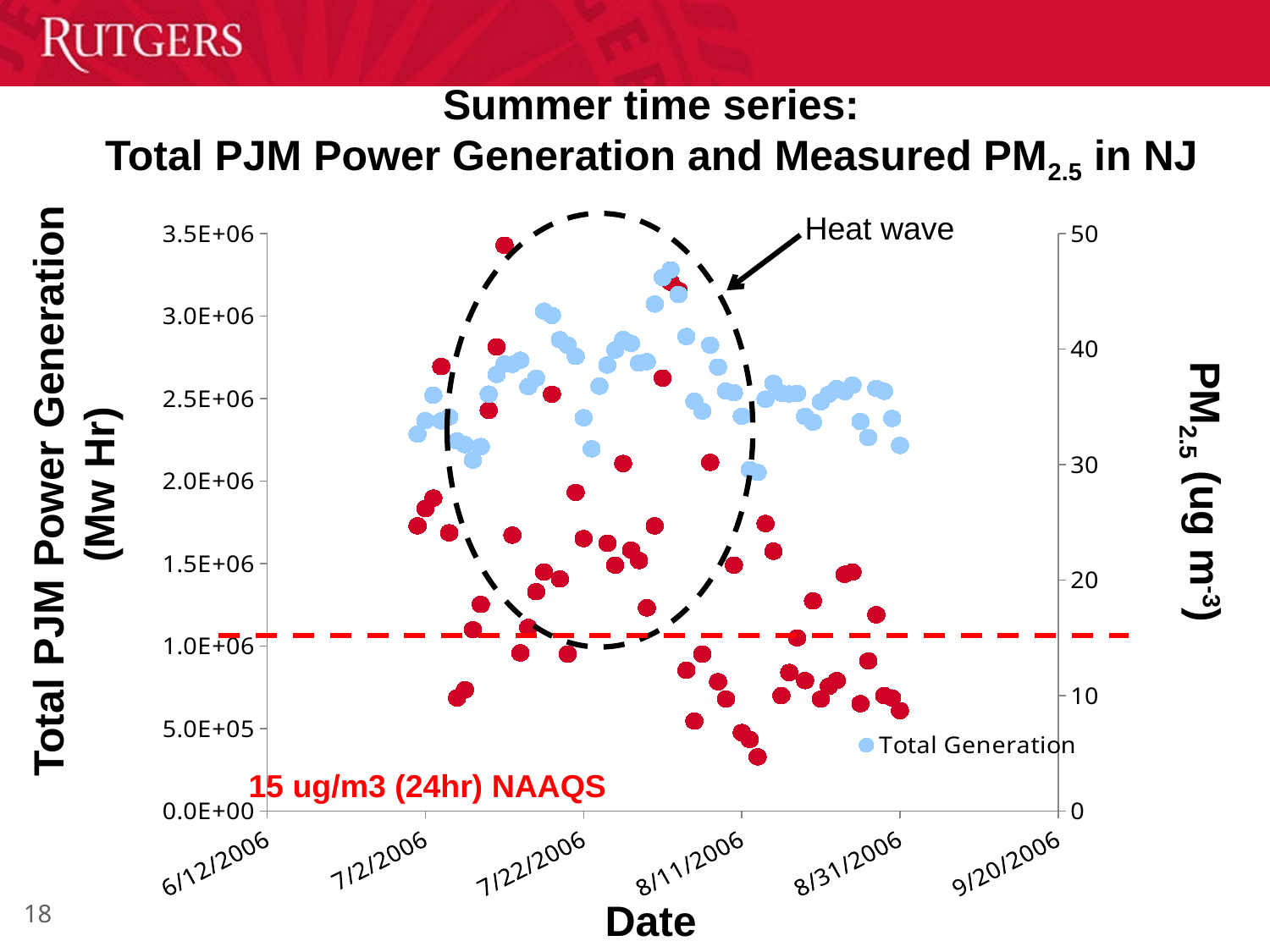
Is the highest Total Generation value greater or less than 3.0E+06? greater What is the last date shown on the x axis? 9/20/2006 What is the highest tick value shown on the left y axis? 3.5E+06 What is the label of the x axis? Date What series does the chart's legend list? Total Generation How many date tick labels are shown on the x axis? 6 What is the first date shown on the x axis? 6/12/2006 What value does the red dashed horizontal line represent? 15 ug/m3 (24hr) NAAQS What kind of chart is shown on the slide? Scatter plot What is the title of the chart on the slide? Summer time series: Total PJM Power Generation and Measured PM2.5 in NJ What is the highest tick value shown on the right y axis? 50 Is the lowest Total Generation value greater or less than 1.5E+06? greater